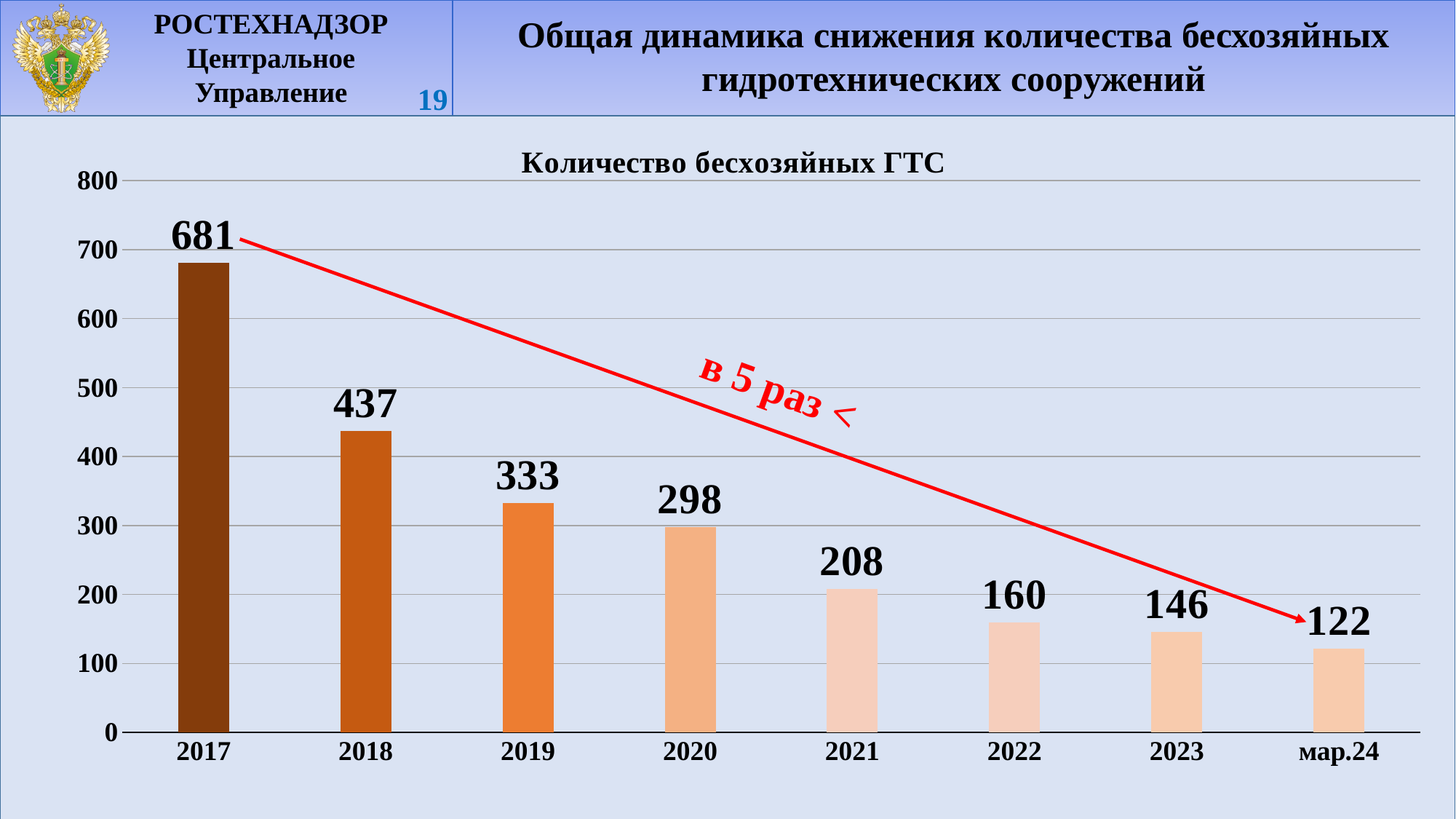
What is the difference between the values for 2022 and 2023? 14 Which category has the lowest value? мар.24 How many categories are shown on the x axis? 8 What kind of chart is shown? bar chart Do the values rise or fall from 2017 to мар.24? fall Which is larger, the value for 2019 or the value for 2020? 2019 Is the value for 2018 greater or less than 400? greater What is the value for 2017? 681 Which category has the highest value? 2017 What is the difference between the values for 2017 and 2018? 244 What is the value for 2021? 208 What is the value for мар.24? 122